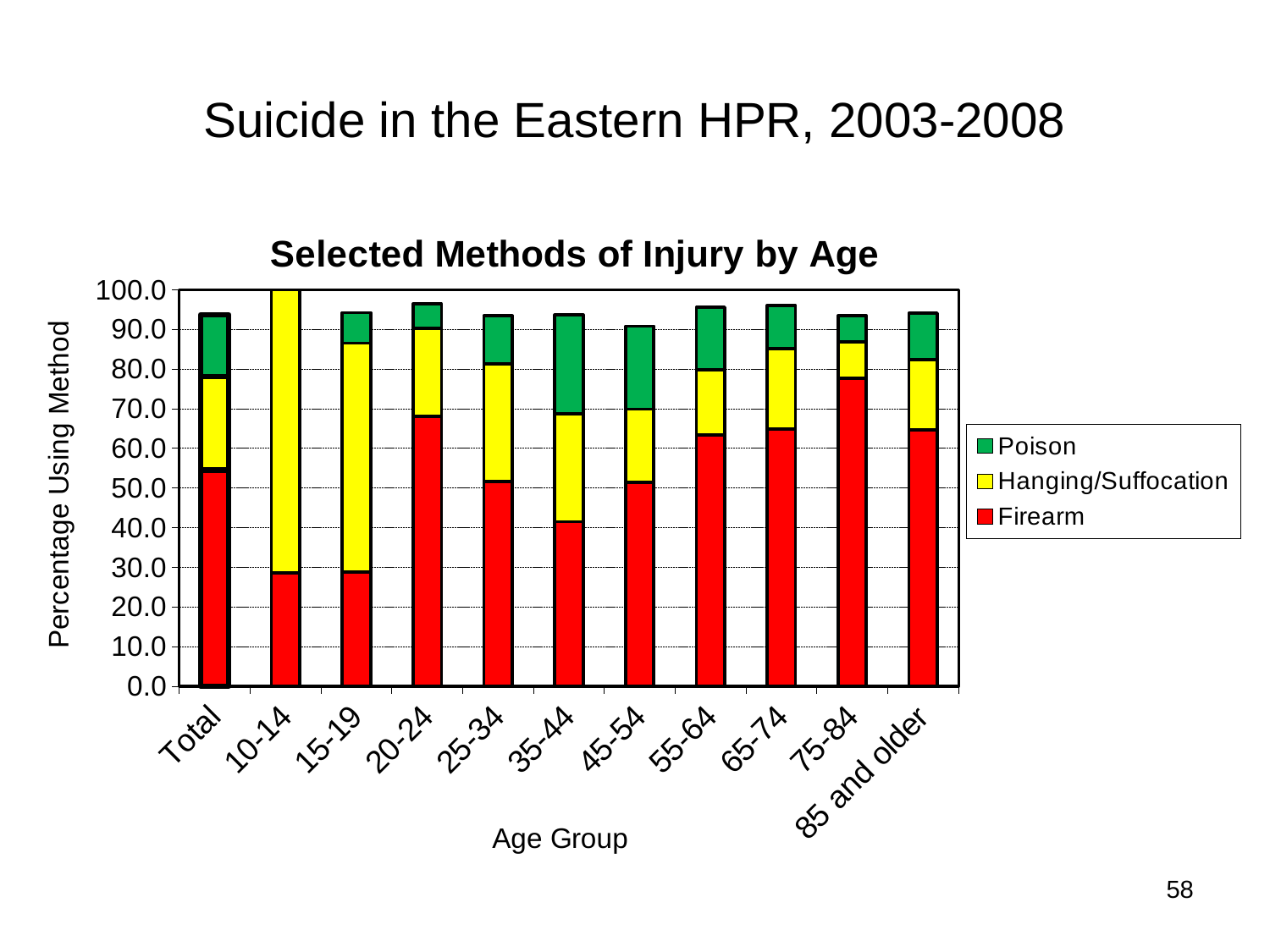
Is the Firearm value for the 10-14 age group greater or less than 40.0? less Which has the larger Firearm percentage, the 20-24 age group or the 25-34 age group? 20-24 Is the Firearm value for the 20-24 age group greater or less than 60.0? greater Which age group has the largest Poison segment? 35-44 Which age group has the highest Firearm percentage? 75-84 How many age-group categories are shown on the x axis of the chart? 11 What is the label of the chart's y axis? Percentage Using Method How many series does the chart's legend list? 3 Is the Firearm value for the 75-84 age group greater or less than 70.0? greater What kind of chart is shown on the slide? stacked bar chart What is the title of the chart? Selected Methods of Injury by Age Which age group has the largest Hanging/Suffocation segment? 10-14